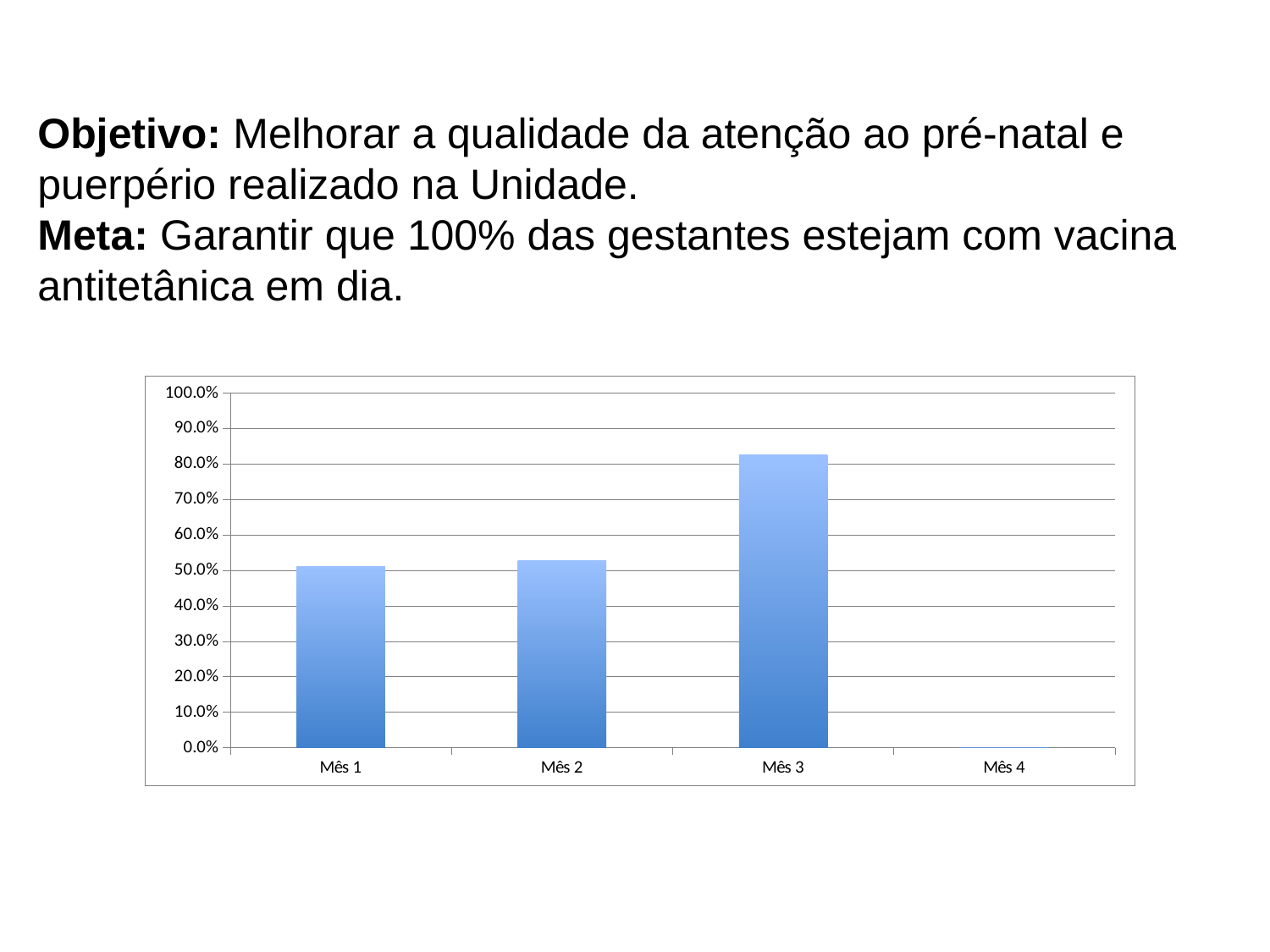
Which month has the highest bar in the chart? Mês 3 Is the value for Mês 3 greater or less than 80.0%? greater Which is larger, the value for Mês 3 or the value for Mês 1? Mês 3 Is the value for Mês 1 greater or less than 40.0%? greater Is the value for Mês 2 greater or less than 50.0%? greater Do the bar values rise or fall from Mês 1 to Mês 3? rise What kind of chart is shown on the slide? bar chart What is the highest value shown on the y axis of the chart? 100.0% How many categories are shown on the x axis of the chart? 4 Which month on the x axis has no bar plotted? Mês 4